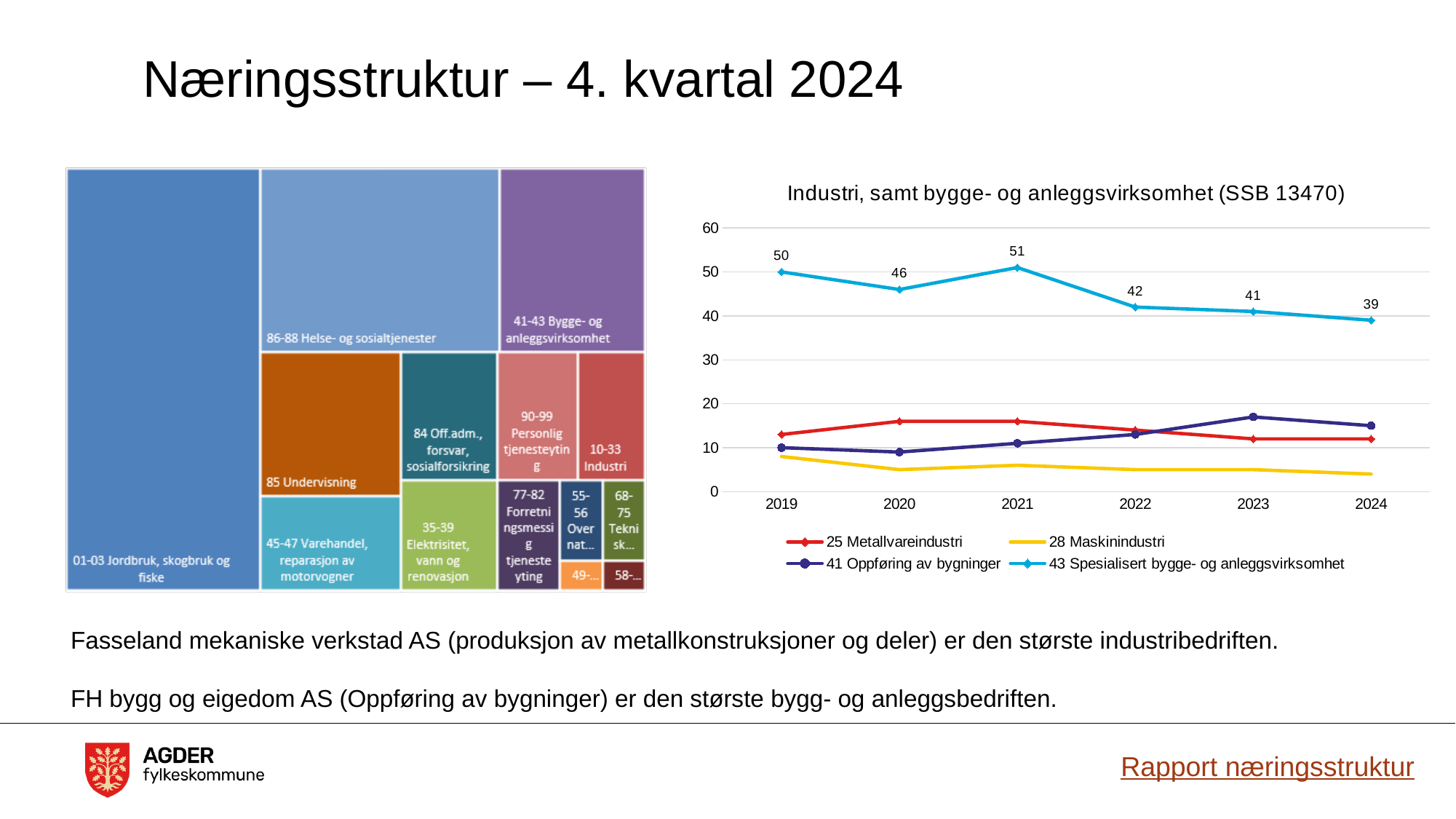
How many years are shown on the x axis of the line chart on the right? 6 On the line chart on the right, does the value for 43 Spesialisert bygge- og anleggsvirksomhet rise or fall from 2021 to 2024? fall On the line chart on the right, what is the value for 43 Spesialisert bygge- og anleggsvirksomhet in 2024? 39 On the treemap on the left of the slide, which category occupies the largest area? 01-03 Jordbruk, skogbruk og fiske On the line chart on the right, in which year does 43 Spesialisert bygge- og anleggsvirksomhet reach its highest value? 2021 On the line chart on the right, in which year is the value for 43 Spesialisert bygge- og anleggsvirksomhet lowest? 2024 On the line chart 'Industri, samt bygge- og anleggsvirksomhet (SSB 13470)', what is the value for 43 Spesialisert bygge- og anleggsvirksomhet in 2019? 50 On the line chart on the right, is the value for 28 Maskinindustri in 2024 greater or less than 10? less On the line chart on the right, which is larger in 2023: 41 Oppføring av bygninger or 25 Metallvareindustri? 41 Oppføring av bygninger What kind of chart is the chart on the right of the slide? line chart How many series does the legend of the line chart on the right list? 4 On the line chart on the right, by how much did 43 Spesialisert bygge- og anleggsvirksomhet fall from 2019 to 2024? 11